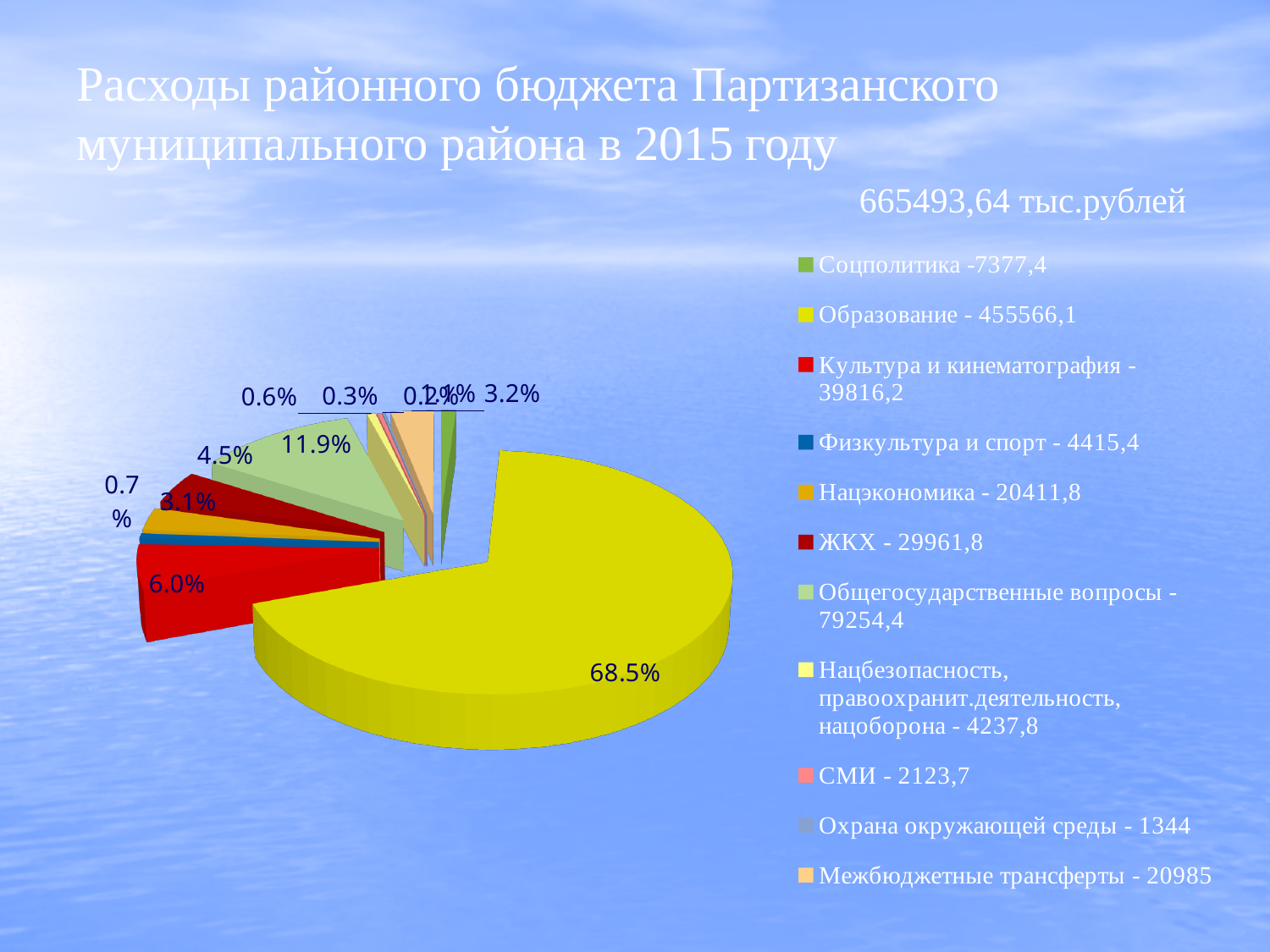
What share of the pie is labelled on the light green slice (Общегосударственные вопросы)? 11.9% What kind of chart is shown on the slide? pie chart What value is given for ЖКХ in the legend? 29961,8 Which category has the smallest expenditure? Охрана окружающей среды Which is larger, Соцполитика or СМИ? Соцполитика How many categories does the legend of the pie chart list? 11 What value is given for Образование in the legend? 455566,1 What share of the pie does the largest slice (Образование) take? 68.5% Which category has the largest expenditure? Образование Which is larger, Культура и кинематография or Нацэкономика? Культура и кинематография What value is given for Общегосударственные вопросы in the legend? 79254,4 What total amount is stated on the slide above the legend? 665493,64 тыс.рублей